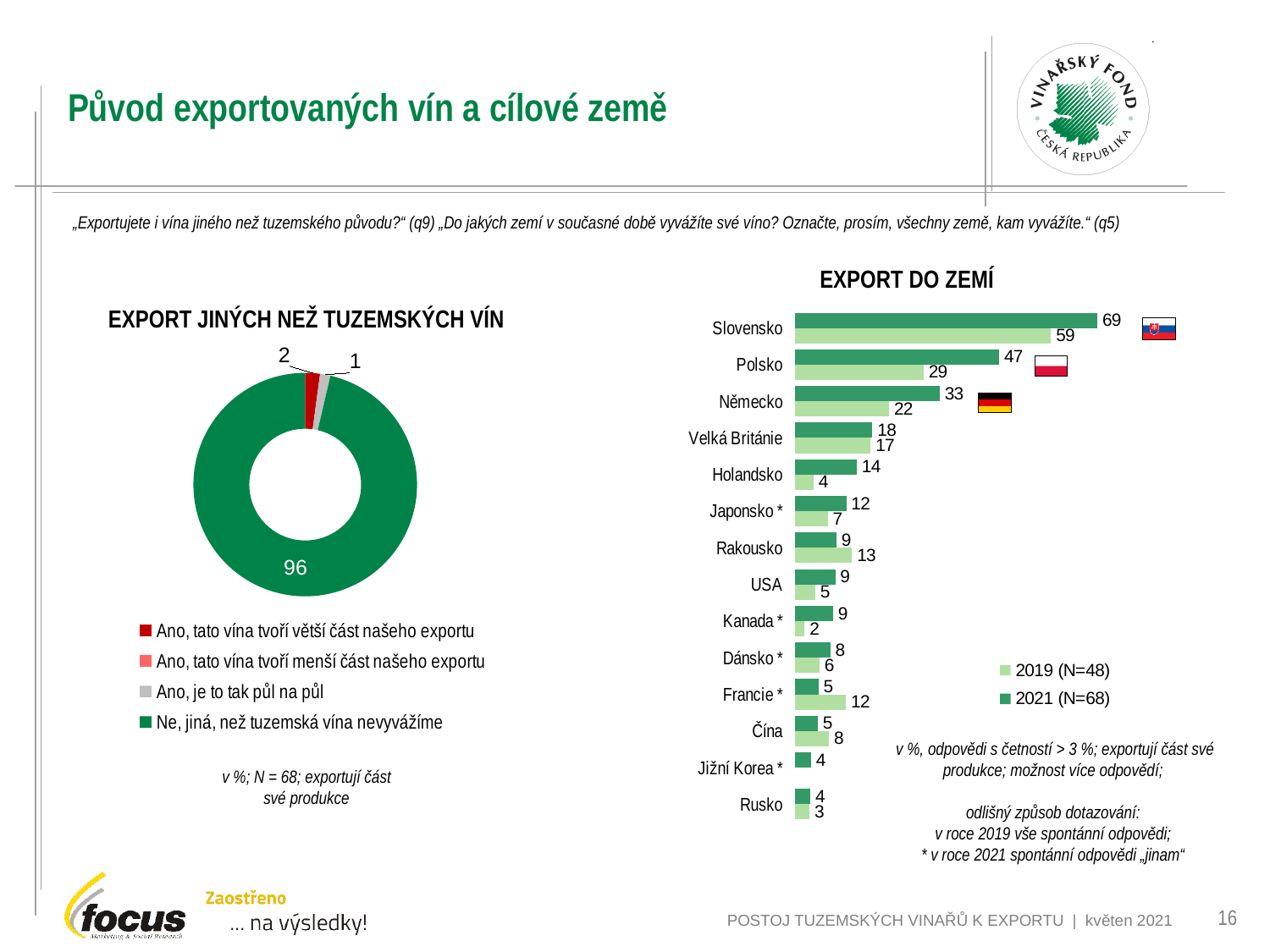
What kind of chart is 'EXPORT DO ZEMÍ'? Bar chart In the chart 'EXPORT DO ZEMÍ', what is the 2019 value for Polsko? 29 In the chart 'EXPORT DO ZEMÍ', what is the 2021 value for Slovensko? 69 What kind of chart is 'EXPORT JINÝCH NEŽ TUZEMSKÝCH VÍN'? Doughnut chart In the chart 'EXPORT DO ZEMÍ', what sample size does the legend give for 2021? N=68 In the chart 'EXPORT DO ZEMÍ', which country has the highest 2021 value? Slovensko In the chart 'EXPORT JINÝCH NEŽ TUZEMSKÝCH VÍN', what is the value of the largest slice? 96 In the chart 'EXPORT DO ZEMÍ', how many series does the legend list? 2 In the chart 'EXPORT DO ZEMÍ', which is larger for Rakousko: the 2019 value or the 2021 value? 2019 In the chart 'EXPORT DO ZEMÍ', what is the 2019 value for Francie? 12 In the chart 'EXPORT DO ZEMÍ', how many countries are listed? 14 In the chart 'EXPORT DO ZEMÍ', what is the difference between the 2021 and 2019 values for Německo? 11